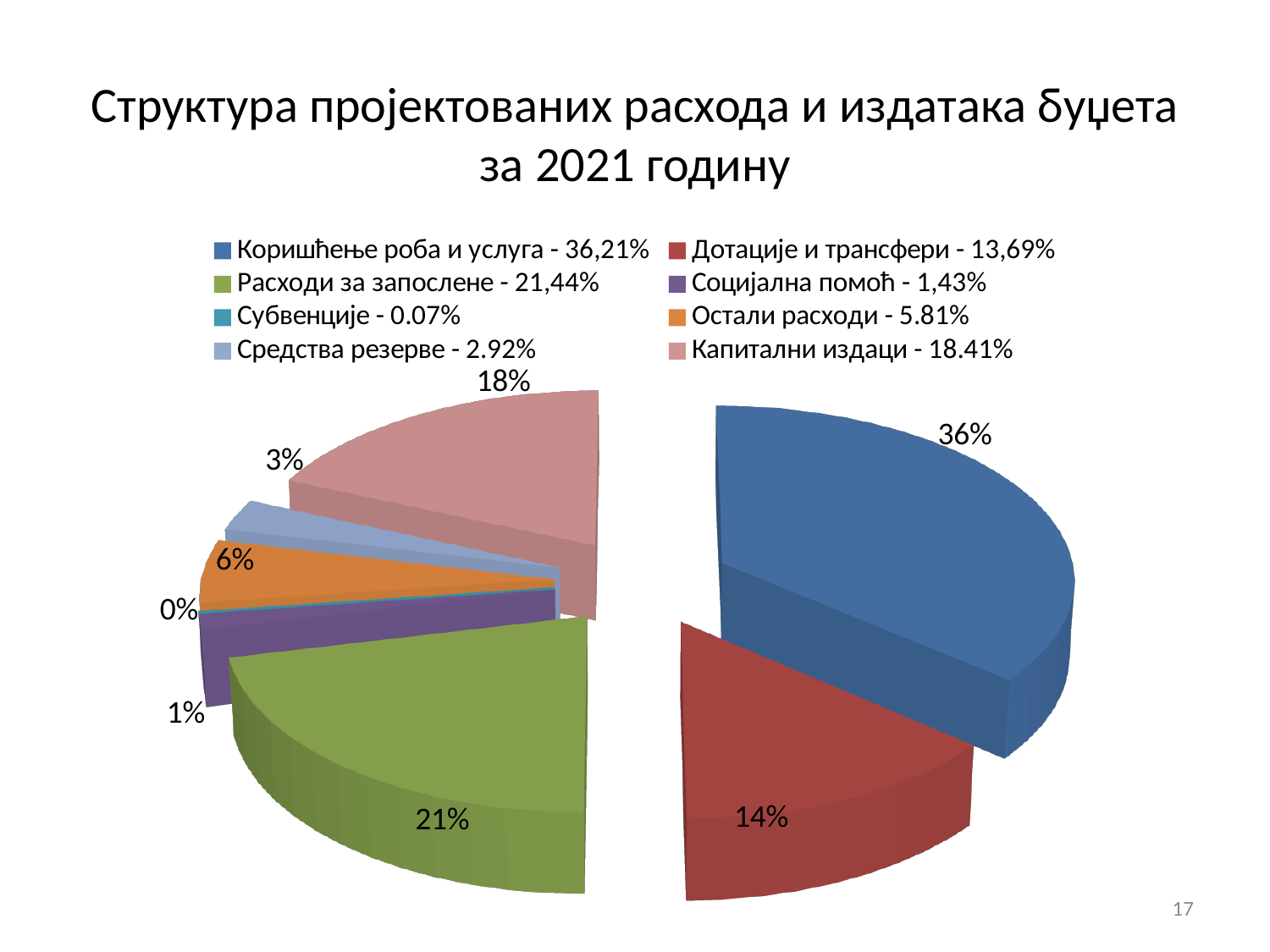
Which category has the smallest share of the pie? Субвенције What is the title of the slide containing the chart? Структура пројектованих расхода и издатака буџета за 2021 годину What percentage label is shown on the slice for Капитални издаци? 18% According to the legend, what is the exact share of Дотације и трансфери? 13,69% How many slices does the pie chart have? 8 What percentage label is shown on the slice for Расходи за запослене? 21% Which category has the largest share of the pie? Коришћење роба и услуга Which is larger: the slice for Дотације и трансфери or the slice for Капитални издаци? Капитални издаци Using the slice labels, what is the difference between the share for Коришћење роба и услуга and the share for Дотације и трансфери? 22% According to the legend, what is the exact share of Средства резерве? 2.92% What kind of chart is shown on the slide? pie chart What percentage label is shown on the slice for Остали расходи? 6%